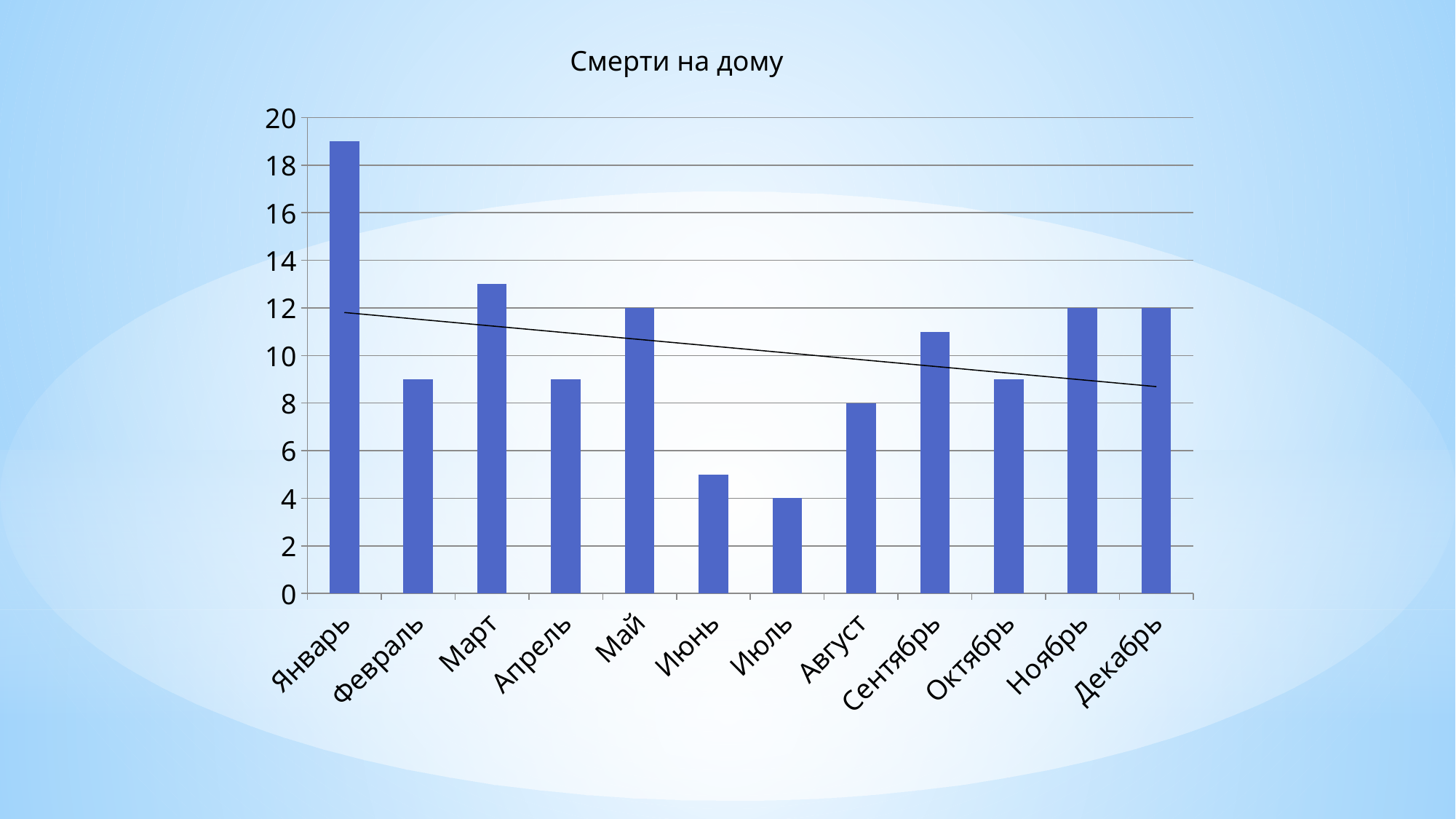
What is the value for Май? 12 How many months are shown on the x axis of the chart? 12 What is the value for Июль? 4 Which month has the highest value in the chart? Январь What is the title of the chart? Смерти на дому What is the difference between the values for Ноябрь and Август? 4 Which is larger, the value for Март or the value for Февраль? Март What kind of chart is shown on the slide? bar chart Which month has the lowest value in the chart? Июль Is the value for Январь greater or less than 18? greater Is the value for Июнь greater or less than 6? less What is the value for Август? 8